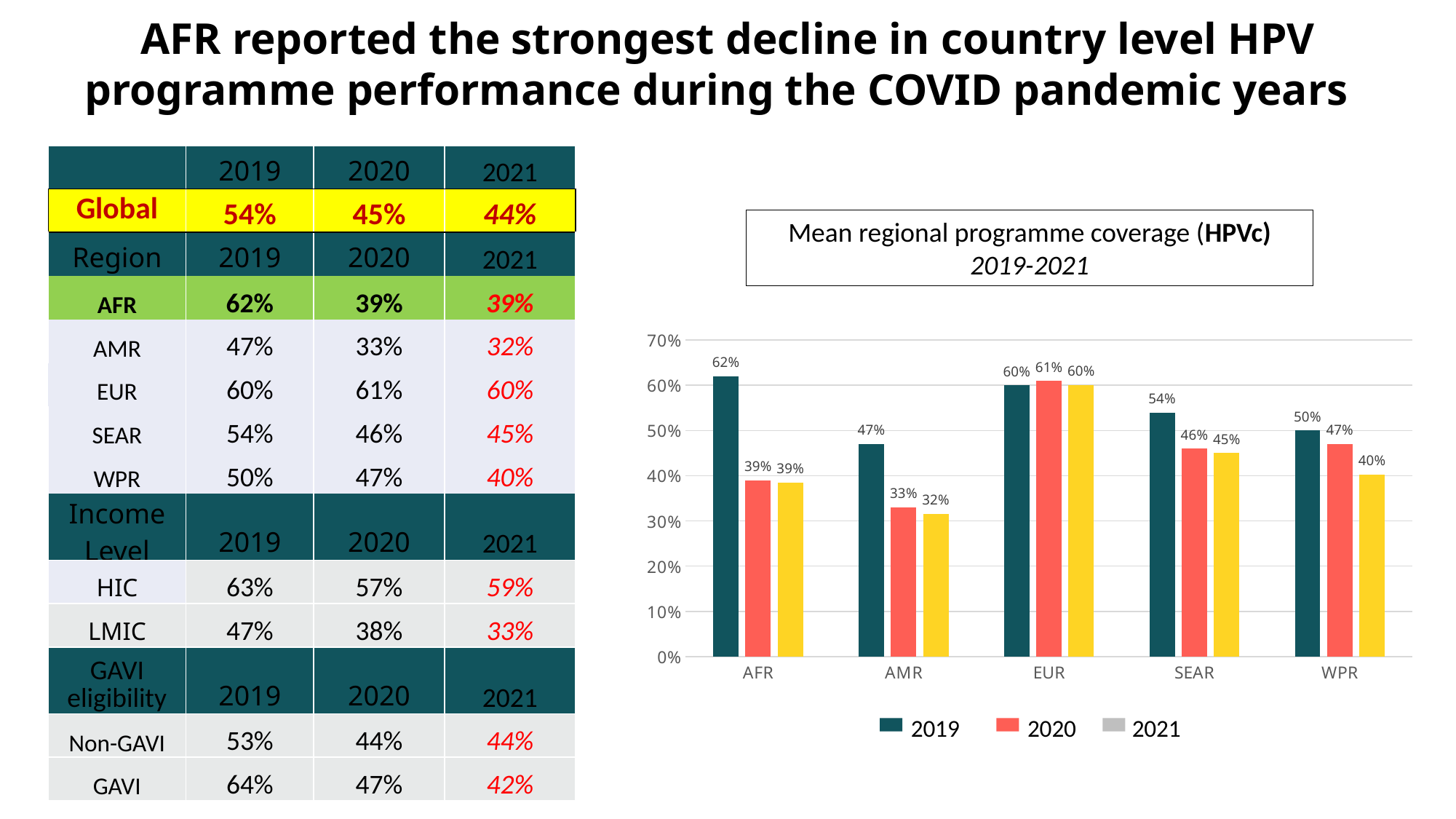
Which region has the lowest 2021 value in the chart? AMR Which region has the highest 2019 value in the chart? AFR How many regions are shown on the x axis of the chart? 5 What is the 2021 value for WPR in the chart? 40% What kind of chart is shown on the slide? Bar chart Which is larger for SEAR: the 2019 value or the 2021 value? 2019 What is the 2019 value for AFR in the chart? 62% Do the values for AMR rise or fall from 2019 to 2021? Fall What is the difference between the 2019 and 2020 values for AFR? 23% What is the 2020 value for EUR in the chart? 61% How many series does the chart legend list? 3 What is the title of the chart? Mean regional programme coverage (HPVc) 2019-2021